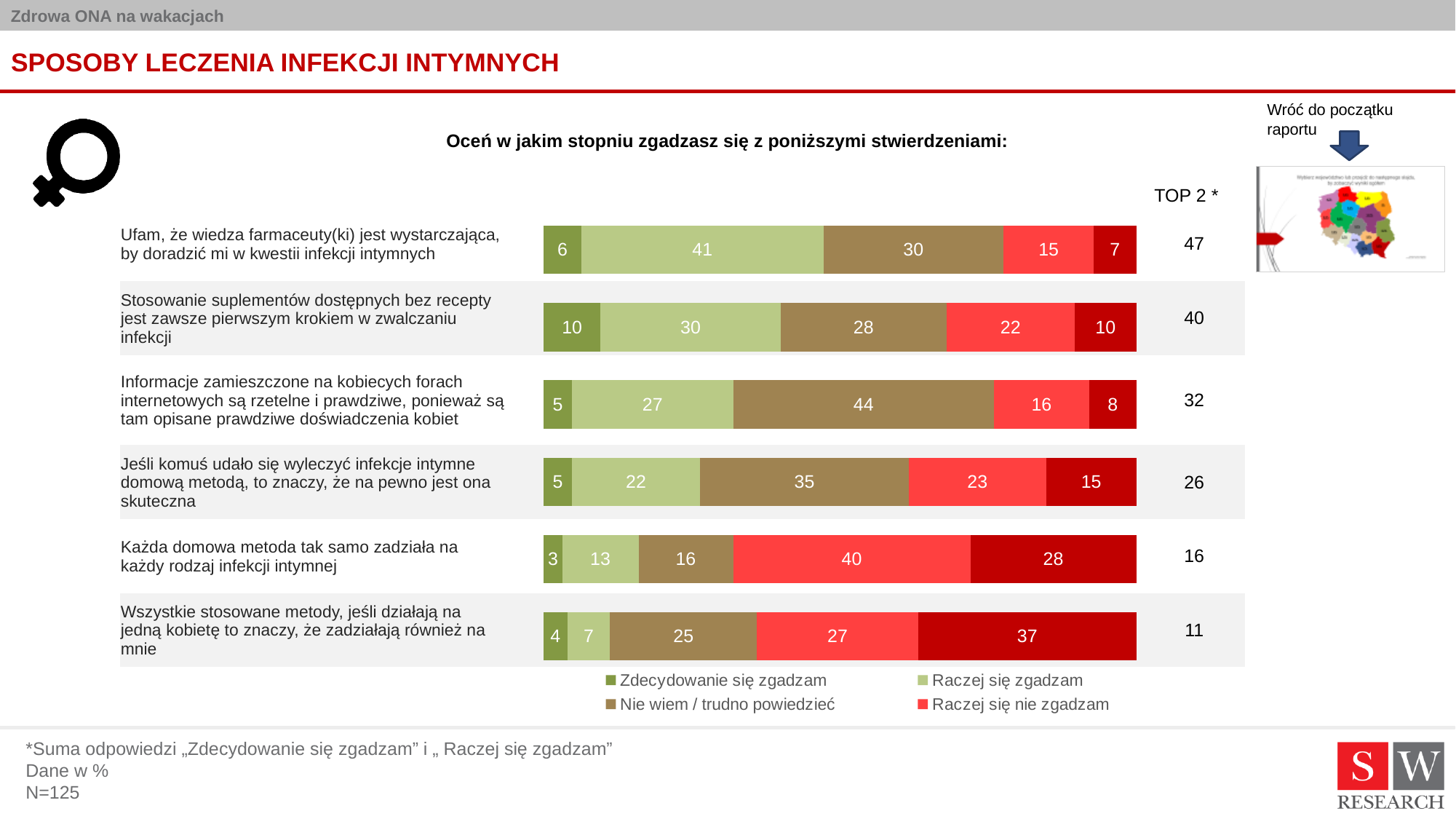
What is the TOP 2 value for the statement "Stosowanie suplementów dostępnych bez recepty jest zawsze pierwszym krokiem w zwalczaniu infekcji"? 40 What is the total of the stacked bar for the statement "Stosowanie suplementów dostępnych bez recepty jest zawsze pierwszym krokiem w zwalczaniu infekcji"? 100 How many statements are shown in the chart? 6 Which statement has the lowest TOP 2 value? Wszystkie stosowane metody, jeśli działają na jedną kobietę to znaczy, że zadziałają również na mnie What is the value for "Raczej się zgadzam" for the statement "Ufam, że wiedza farmaceuty(ki) jest wystarczająca, by doradzić mi w kwestii infekcji intymnych"? 41 What kind of chart is shown on the slide? Stacked bar chart What is the value for "Nie wiem / trudno powiedzieć" for the statement "Informacje zamieszczone na kobiecych forach internetowych są rzetelne i prawdziwe..."? 44 What is the difference between the highest TOP 2 value (47) and the lowest TOP 2 value (11)? 36 Which statement has the larger "Raczej się nie zgadzam" value: "Każda domowa metoda tak samo zadziała na każdy rodzaj infekcji intymnej" or "Jeśli komuś udało się wyleczyć infekcje intymne domową metodą..."? Każda domowa metoda tak samo zadziała na każdy rodzaj infekcji intymnej How many entries does the chart legend list? 4 What is the value for "Zdecydowanie się zgadzam" for the statement "Każda domowa metoda tak samo zadziała na każdy rodzaj infekcji intymnej"? 3 Which statement has the highest TOP 2 value? Ufam, że wiedza farmaceuty(ki) jest wystarczająca, by doradzić mi w kwestii infekcji intymnych